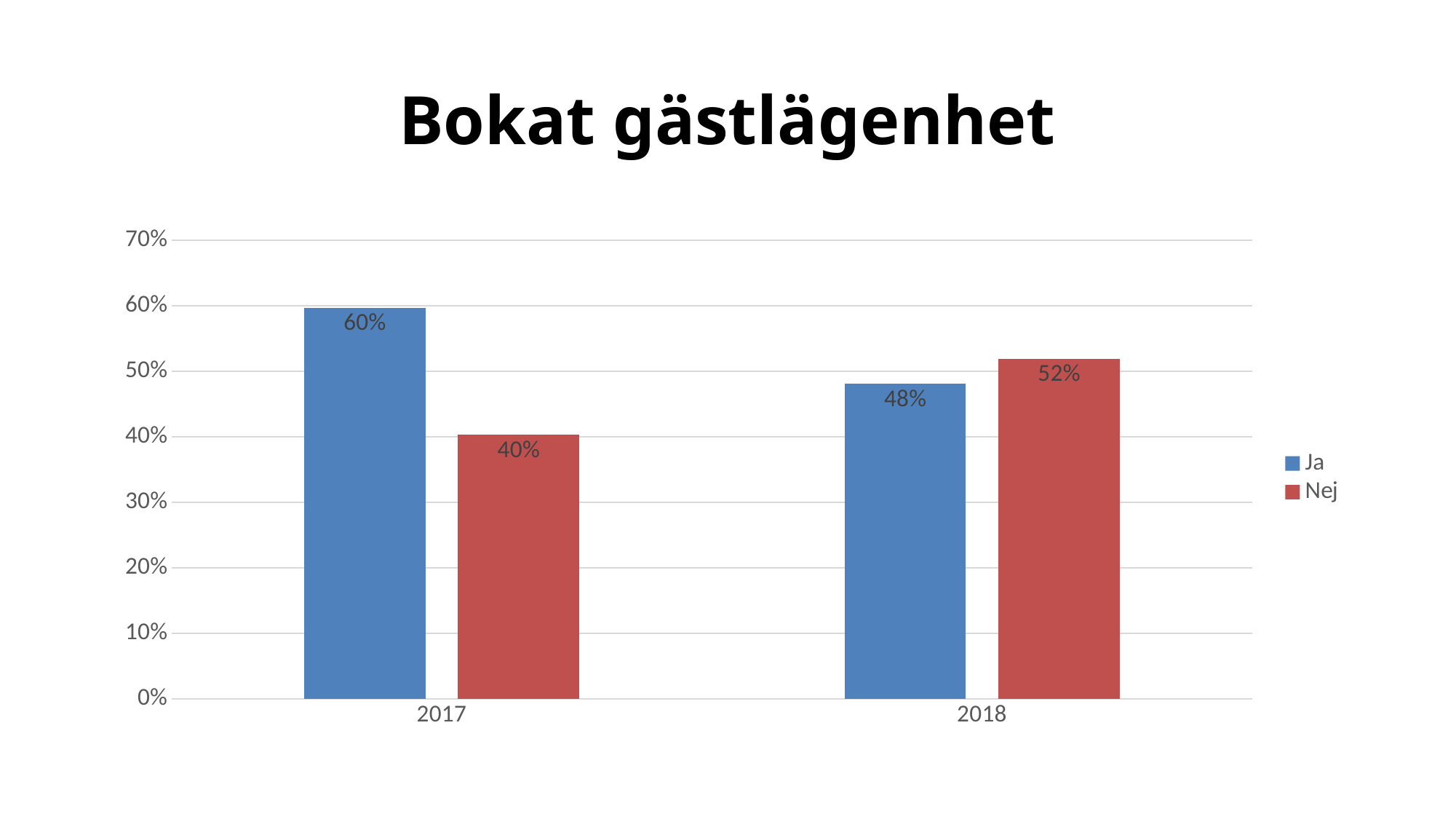
What is the value for Ja in 2017? 60% What is the value for Nej in 2018? 52% Which bar has the lowest value on the chart? Nej in 2017 Does the value for Ja rise or fall from 2017 to 2018? Fall Which series has the highest value in 2017? Ja Which is larger in 2018, Ja or Nej? Nej What is the difference between Ja and Nej in 2017? 20% How many years are shown on the x axis? 2 What is the value for Ja in 2018? 48% How many series does the legend list? 2 What kind of chart is shown? Bar chart What is the difference between Nej in 2018 and Nej in 2017? 12%